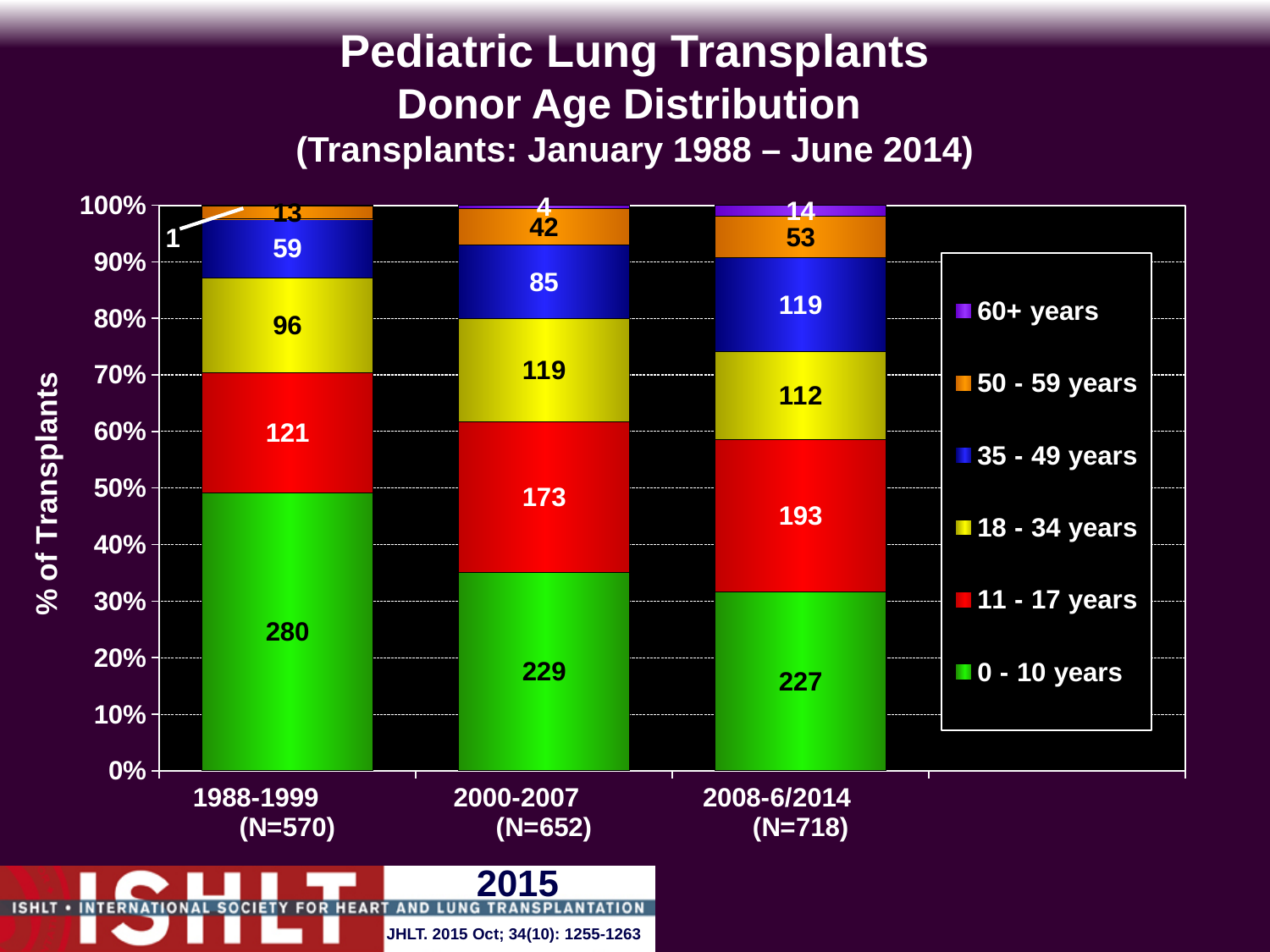
How many donor age groups does the legend list? 6 What is the value for the 60+ years donor group in the 1988-1999 period? 1 How many transplants in 2000-2007 had donors aged 50 - 59 years? 42 What is the number of transplants with donors aged 35 - 49 years in the 2008-6/2014 period? 119 Is the share of transplants with donors aged 0 - 10 years in 2008-6/2014 greater or less than 40%? less Which donor age group has the smallest count in the 2000-2007 period? 60+ years What is the difference between the 11 - 17 years counts in 2008-6/2014 and 1988-1999? 72 How many pediatric lung transplants in 1988-1999 had donors aged 0 - 10 years? 280 How many time periods are shown on the x axis? 3 Which donor age group has the largest count in the 2008-6/2014 period? 0 - 10 years Which is larger: the 18 - 34 years count in 2000-2007 or in 2008-6/2014? 2000-2007 What kind of chart is shown on the slide? Stacked bar chart